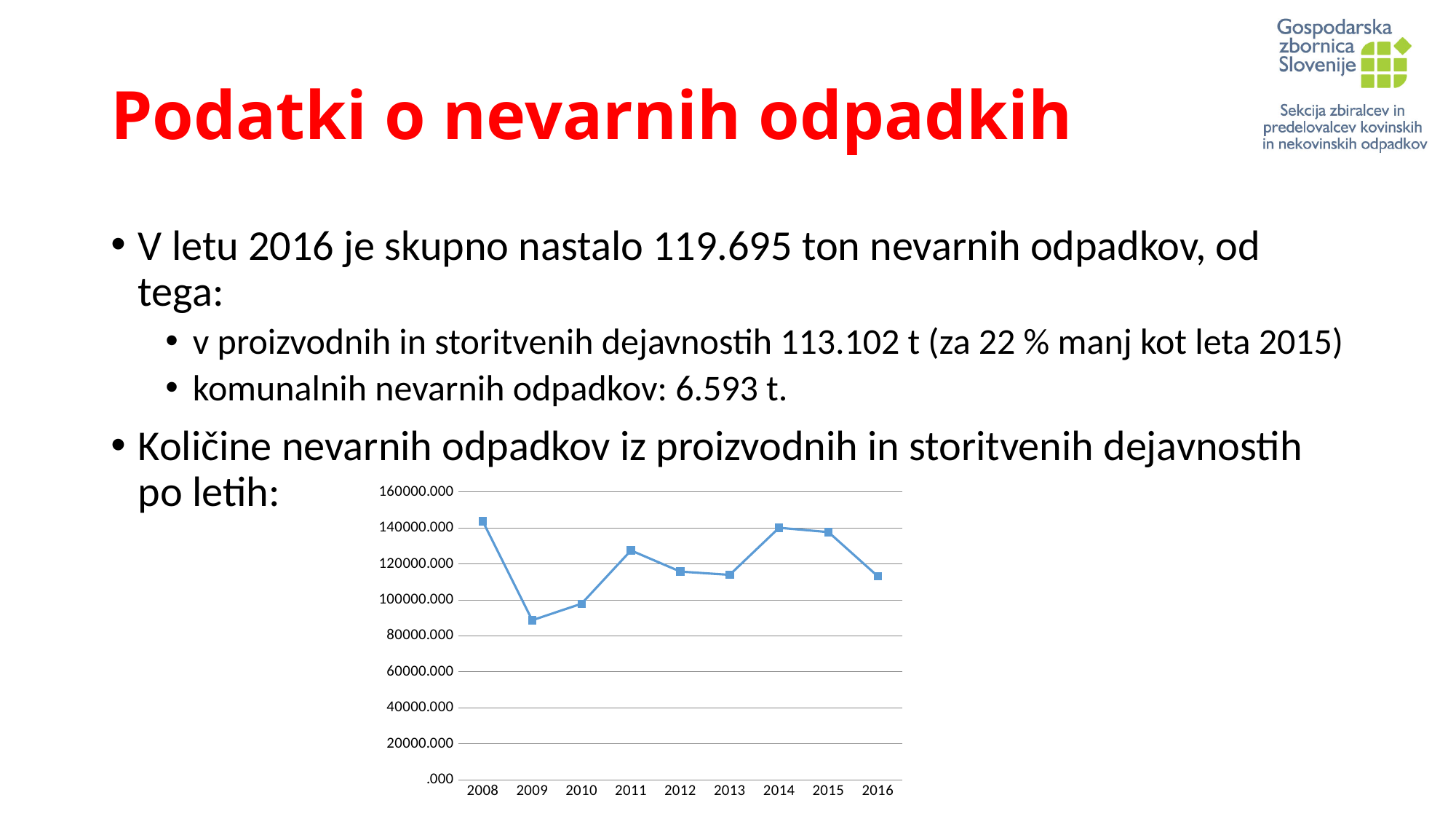
Which year has the lowest value in the chart? 2009 Do the values rise or fall from 2014 to 2016? fall Which is larger, the value for 2014 or the value for 2016? 2014 What kind of chart is shown on the slide? line chart What is the highest value shown on the y axis of the chart? 160000.000 Is the value for 2009 greater or less than 100000.000? less How many years are plotted on the x axis of the chart? 9 Which is larger, the value for 2011 or the value for 2009? 2011 Is the value for 2016 greater or less than 120000.000? less Is the value for 2008 greater or less than 140000.000? greater